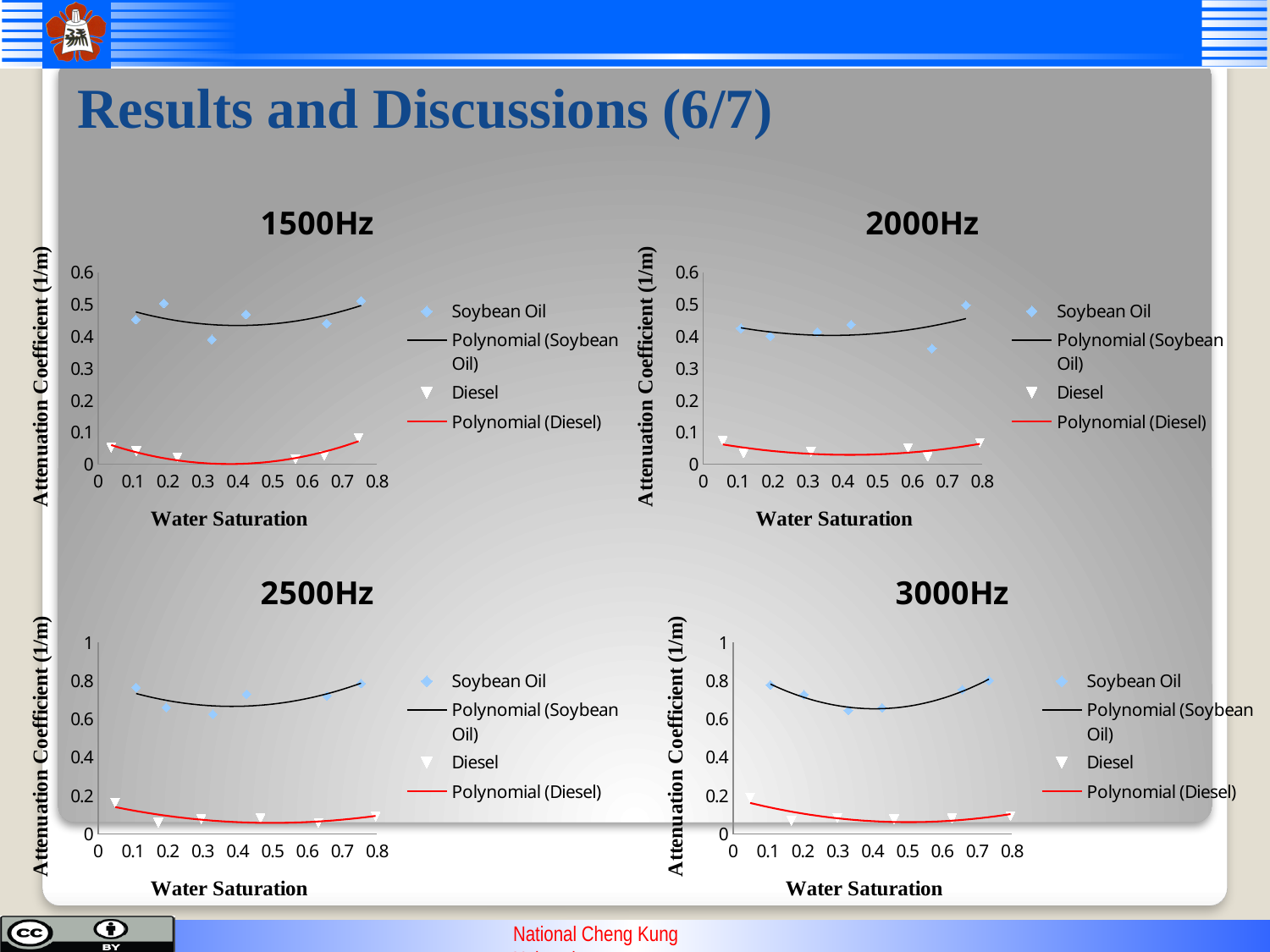
In the 3000Hz chart, which series has lower attenuation coefficient values, Soybean Oil or Diesel? Diesel What is the label of the x axis on the 3000Hz chart? Water Saturation What type of chart is the 1500Hz chart? scatter chart In the 1500Hz chart, which series has higher attenuation coefficient values, Soybean Oil or Diesel? Soybean Oil In the 3000Hz chart, is the Diesel value at water saturation 0.3 greater or less than 0.4? less In the 2500Hz chart, is the Soybean Oil value at water saturation 0.1 greater or less than 0.6? greater In the 2000Hz chart, is the Diesel value at water saturation 0.1 greater or less than 0.2? less How many series does the legend of the 2000Hz chart list? 4 What is the label of the y axis on the 2500Hz chart? Attenuation Coefficient (1/m)